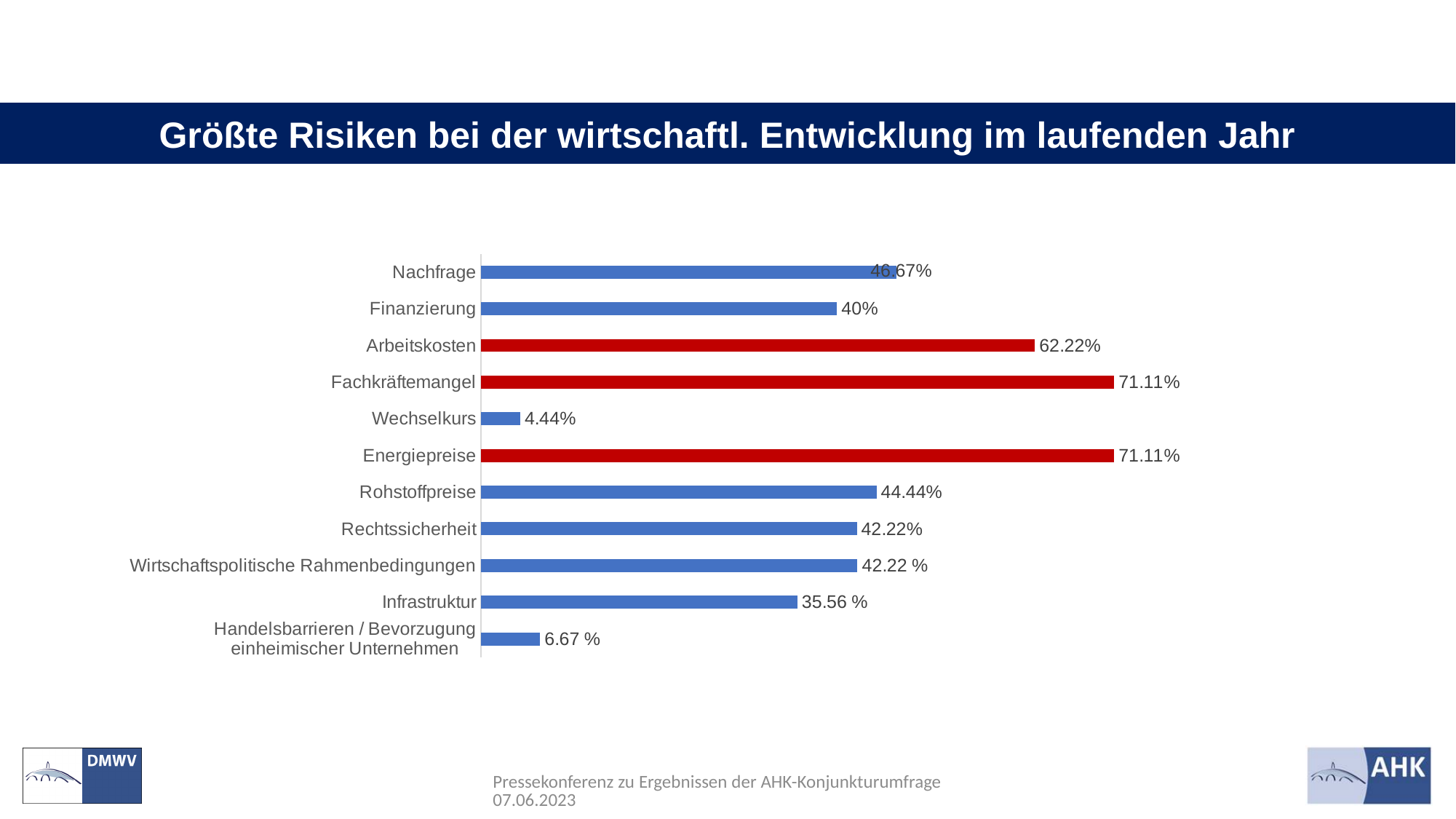
How many categories are shown in the chart? 11 What is the value for Arbeitskosten? 62.22% What is the difference between the values for Fachkräftemangel and Arbeitskosten? 8.89% Which two categories share the highest value of 71.11%? Fachkräftemangel and Energiepreise What is the value for Wechselkurs? 4.44% Which category has the lowest value? Wechselkurs What kind of chart is shown on the slide? bar chart What is the value for Infrastruktur? 35.56 % Which bars are coloured red rather than blue? Arbeitskosten, Fachkräftemangel and Energiepreise What is the value for Handelsbarrieren / Bevorzugung einheimischer Unternehmen? 6.67 % What is the difference between the values for Nachfrage and Finanzierung? 6.67% Which is larger, the value for Rohstoffpreise or the value for Rechtssicherheit? Rohstoffpreise